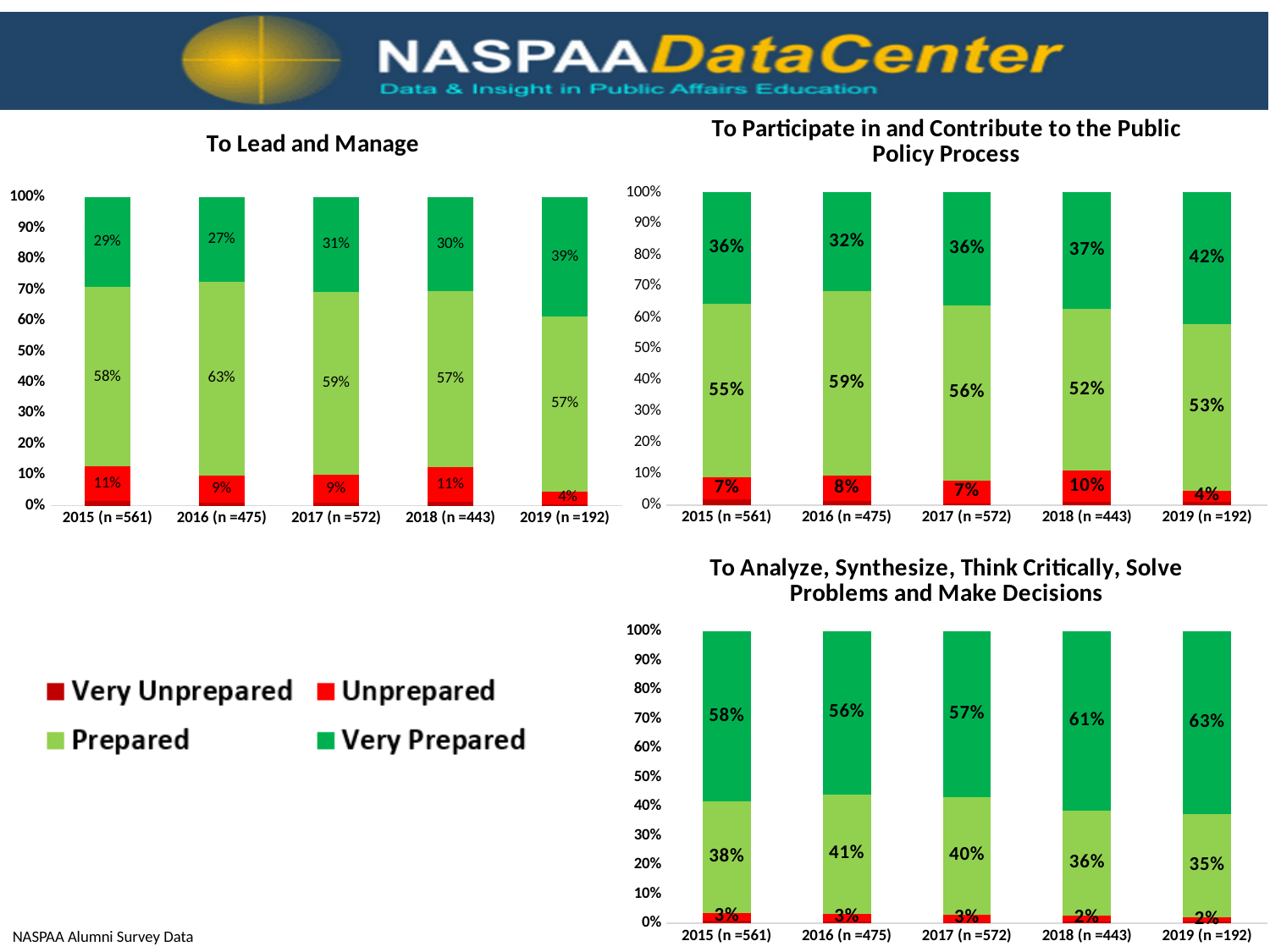
In the 'To Lead and Manage' chart, which year has the highest Prepared percentage? 2016 (n =475) How many series does the legend list? 4 In the 'To Lead and Manage' chart, what percentage of 2019 (n =192) respondents were Very Prepared? 39% In the 'To Lead and Manage' chart, which year has the lowest Unprepared percentage? 2019 (n =192) In the 'To Analyze, Synthesize, Think Critically, Solve Problems and Make Decisions' chart, does the Very Prepared percentage rise or fall from 2017 (n =572) to 2019 (n =192)? rise In the 'To Analyze, Synthesize, Think Critically, Solve Problems and Make Decisions' chart, what is the Very Prepared percentage for 2017 (n =572)? 57% In the 'To Participate in and Contribute to the Public Policy Process' chart, what is the Prepared percentage for 2018 (n =443)? 52% In the 'To Participate in and Contribute to the Public Policy Process' chart, what is the difference between the Very Prepared percentages for 2019 (n =192) and 2016 (n =475)? 10% What type of chart is 'To Participate in and Contribute to the Public Policy Process'? stacked bar chart In the 'To Analyze, Synthesize, Think Critically, Solve Problems and Make Decisions' chart, is the Very Prepared percentage larger for 2015 (n =561) or 2019 (n =192)? 2019 (n =192) How many year categories are shown in the 'To Lead and Manage' chart? 5 In the 'To Participate in and Contribute to the Public Policy Process' chart, which year has the highest Unprepared percentage? 2018 (n =443)